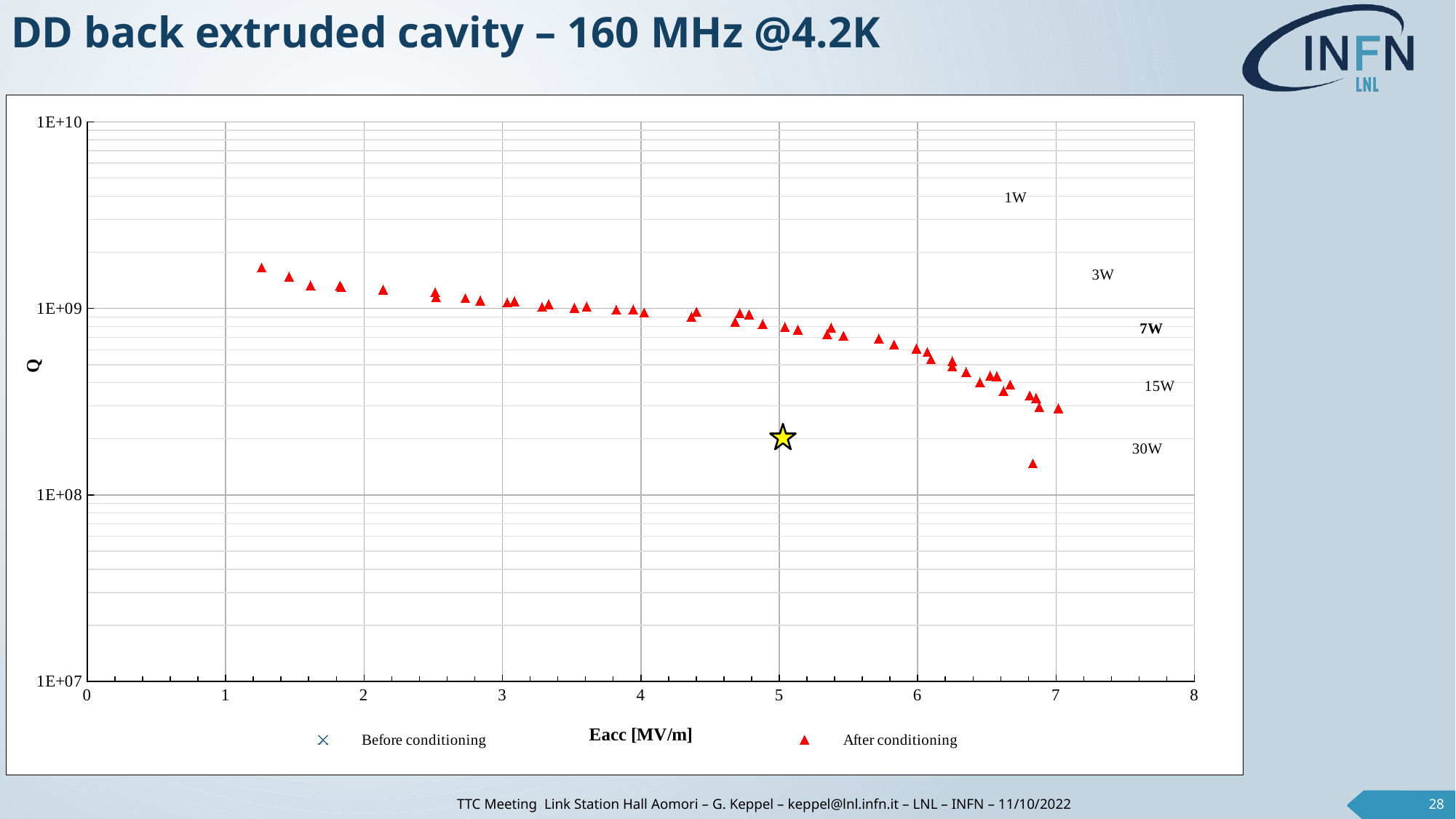
Is the Q value of the After conditioning point at the lowest Eacc (around 1.25 MV/m) greater or less than 1E+09? greater What is the label of the x axis of the chart? Eacc [MV/m] What kind of chart is shown on the slide? Scatter chart What is the maximum Eacc value shown on the x axis of the chart? 8 As Eacc increases along the x axis, do the After conditioning Q values generally rise or fall? Fall Is the Q value of the After conditioning point at Eacc of about 7 MV/m greater or less than 1E+08? greater Which has the higher Q value: the After conditioning point at about 2 MV/m or the one at about 6 MV/m? The point at about 2 MV/m What are the two series named in the chart legend? Before conditioning and After conditioning Is the Q value of the After conditioning point at Eacc of about 7 MV/m greater or less than 1E+09? less How many series does the chart legend list? 2